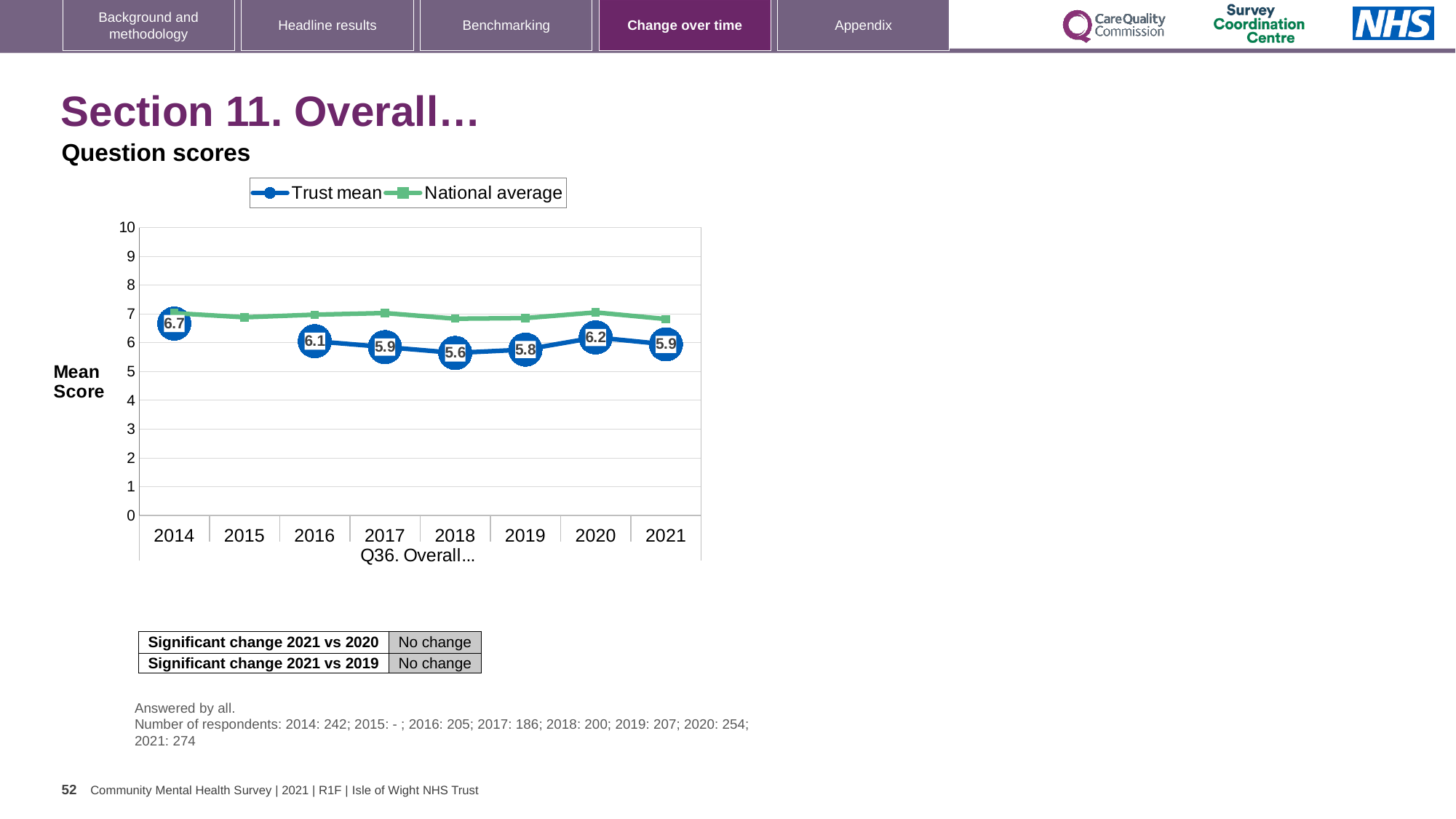
What is the difference between the Trust mean in 2014 and in 2018? 1.1 How many series does the legend list? 2 Is the National average value for 2021 greater or less than 6? greater Does the Trust mean rise or fall from 2016 to 2018? Fall What kind of chart is shown on the slide? Line chart In which year is the Trust mean lowest? 2018 What is the Trust mean value for 2018? 5.6 In which year is the Trust mean highest? 2014 What is the Trust mean value for 2014? 6.7 How many years are shown on the x axis? 8 What is the Trust mean value for 2021? 5.9 Which is larger, the Trust mean in 2020 or in 2021? 2020